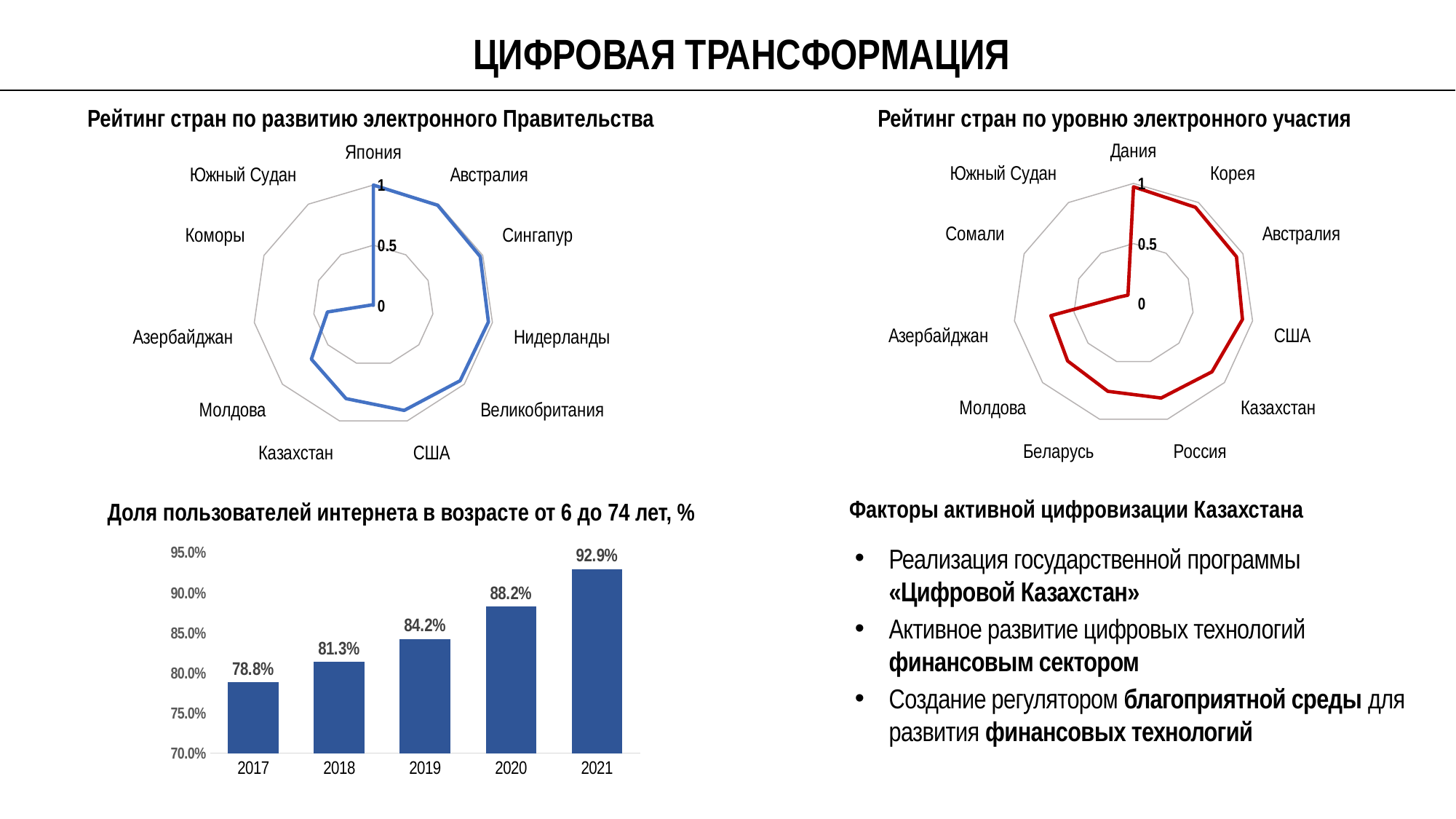
In the chart 'Доля пользователей интернета в возрасте от 6 до 74 лет, %', which year has the highest value? 2021 In the chart 'Доля пользователей интернета в возрасте от 6 до 74 лет, %', do the values rise or fall from 2017 to 2021? rise How many countries are shown in the chart 'Рейтинг стран по уровню электронного участия'? 11 In the chart 'Доля пользователей интернета в возрасте от 6 до 74 лет, %', how many years are shown? 5 In the chart 'Рейтинг стран по уровню электронного участия', is the value for Сомали greater or less than 0.5? less In the chart 'Доля пользователей интернета в возрасте от 6 до 74 лет, %', what is the value for 2017? 78.8% In the chart 'Рейтинг стран по развитию электронного Правительства', is the value for Южный Судан greater or less than 0.5? less In the chart 'Доля пользователей интернета в возрасте от 6 до 74 лет, %', what is the value for 2021? 92.9% In the chart 'Доля пользователей интернета в возрасте от 6 до 74 лет, %', which year has the lowest value? 2017 What kind of chart is 'Доля пользователей интернета в возрасте от 6 до 74 лет, %'? bar chart In the chart 'Рейтинг стран по развитию электронного Правительства', is the value for Япония greater or less than 0.5? greater In the chart 'Доля пользователей интернета в возрасте от 6 до 74 лет, %', what is the difference between the 2021 and 2020 values? 4.7%